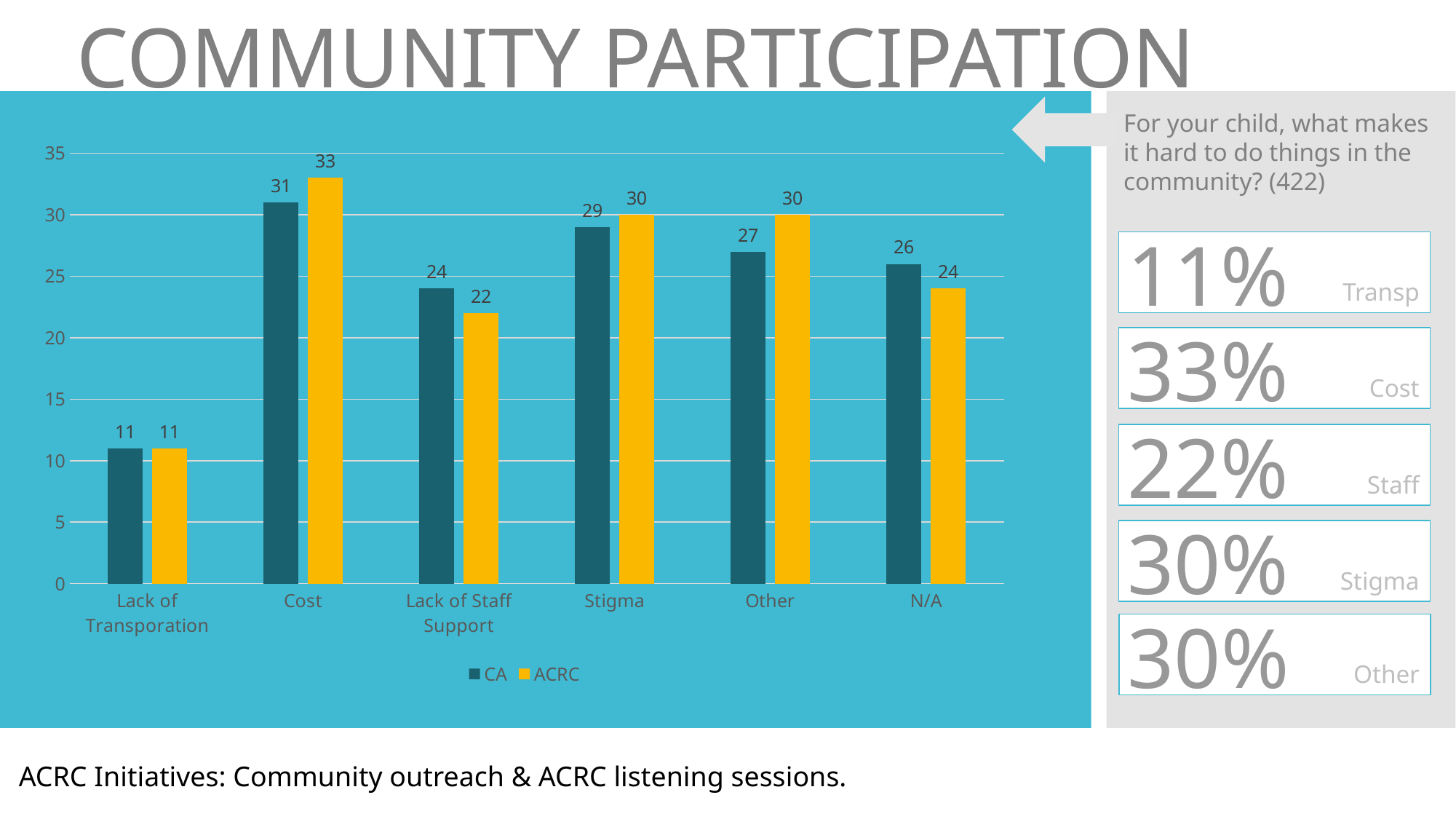
What is the CA value for Cost? 31 What kind of chart is shown on the slide? bar chart Which category has the highest ACRC value? Cost Which category has the lowest CA value? Lack of Transporation Which is larger for N/A, the CA value or the ACRC value? CA How many categories are shown on the x axis? 6 What is the difference between the ACRC and CA values for Cost? 2 What is the ACRC value for Lack of Staff Support? 22 What is the ACRC value for N/A? 24 Is the CA value for Other greater or less than 25? greater What colour are the ACRC bars? yellow How many series does the legend list? 2